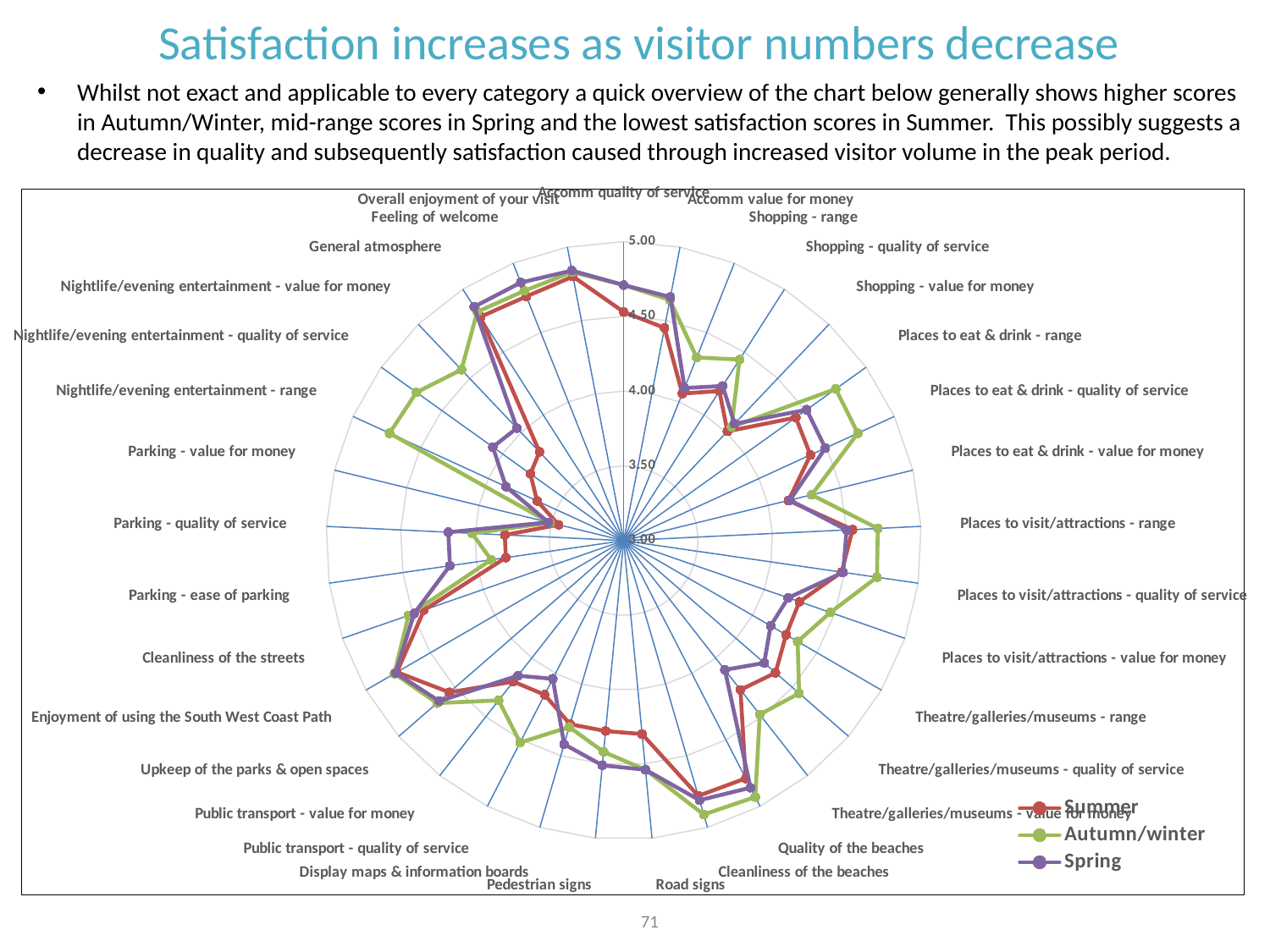
What kind of chart is shown on the slide? Radar chart What are the lowest and highest values marked on the chart's radial axis? 3.00 and 5.00 Is the Autumn/winter value for Nightlife/evening entertainment - range greater or less than 4.50? greater What are the three series named in the chart's legend? Summer, Autumn/winter, Spring For Nightlife/evening entertainment - range, which series has the higher value: Summer or Autumn/winter? Autumn/winter How many series does the chart's legend list? 3 Is the Autumn/winter value for Quality of the beaches greater or less than 4.50? greater Is the Spring value for General atmosphere greater or less than 4.50? greater For Places to eat & drink - range, which series has the higher value: Summer or Autumn/winter? Autumn/winter How many categories are plotted around the radar chart? 33